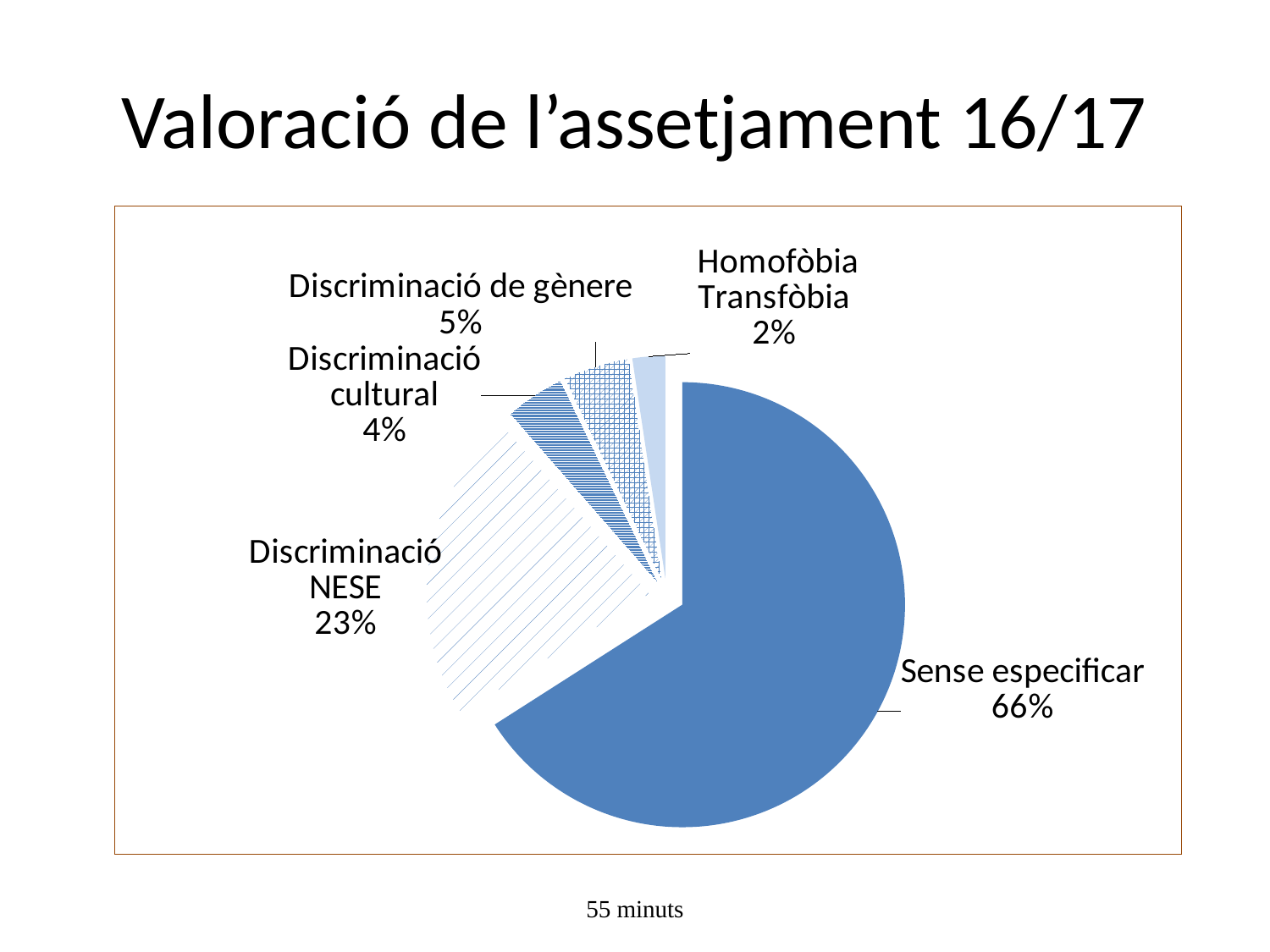
What share of the pie does "Discriminació NESE" represent? 23% What share of the pie does "Sense especificar" represent? 66% What kind of chart is shown on the slide? pie chart How many slices does the pie chart have? 5 Which is larger, the slice for "Discriminació de gènere" or the slice for "Discriminació cultural"? Discriminació de gènere What percentage is shown for "Discriminació de gènere"? 5% What percentage is shown for "Discriminació cultural"? 4% Which category has the smallest slice of the pie? Homofòbia Transfòbia What percentage is shown for "Homofòbia Transfòbia"? 2% What is the difference in percentage points between "Sense especificar" and "Discriminació NESE"? 43 Which category has the largest slice of the pie? Sense especificar What is the title of the slide containing the chart? Valoració de l’assetjament 16/17